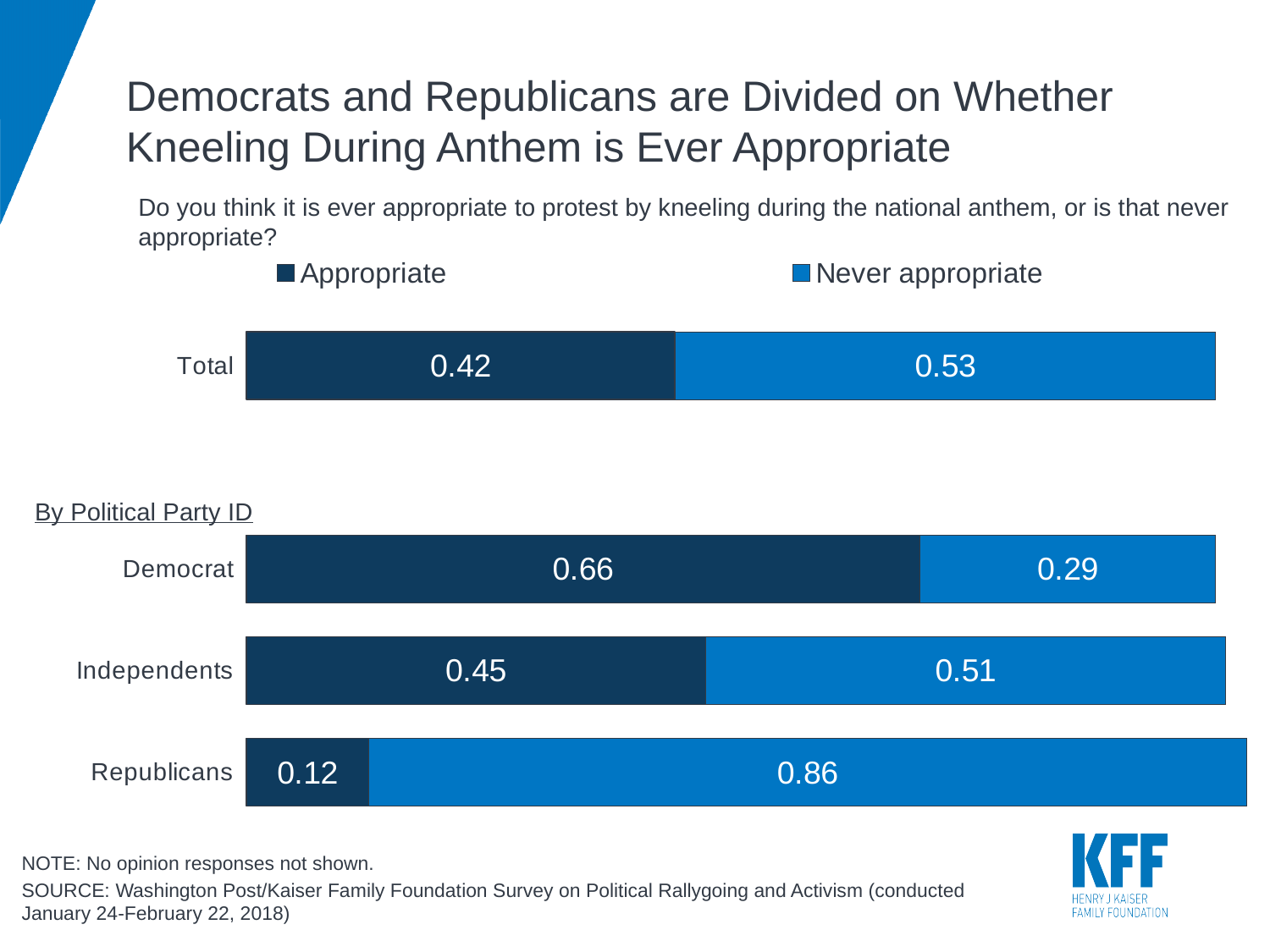
What is the total of the stacked bar for Republicans? 0.98 Which is larger for Independents: 'Appropriate' or 'Never appropriate'? Never appropriate Which category has the lowest 'Never appropriate' value? Democrat What is the 'Appropriate' value for Independents? 0.45 What is the 'Appropriate' value for Democrat? 0.66 What is the difference between the 'Never appropriate' values for Republicans and Democrat? 0.57 What is the 'Never appropriate' value for Total? 0.53 What is the 'Never appropriate' value for Republicans? 0.86 How many categories are shown in the chart? 4 How many series does the legend list? 2 Which category has the highest 'Appropriate' value? Democrat What kind of chart is shown on the slide? Stacked bar chart